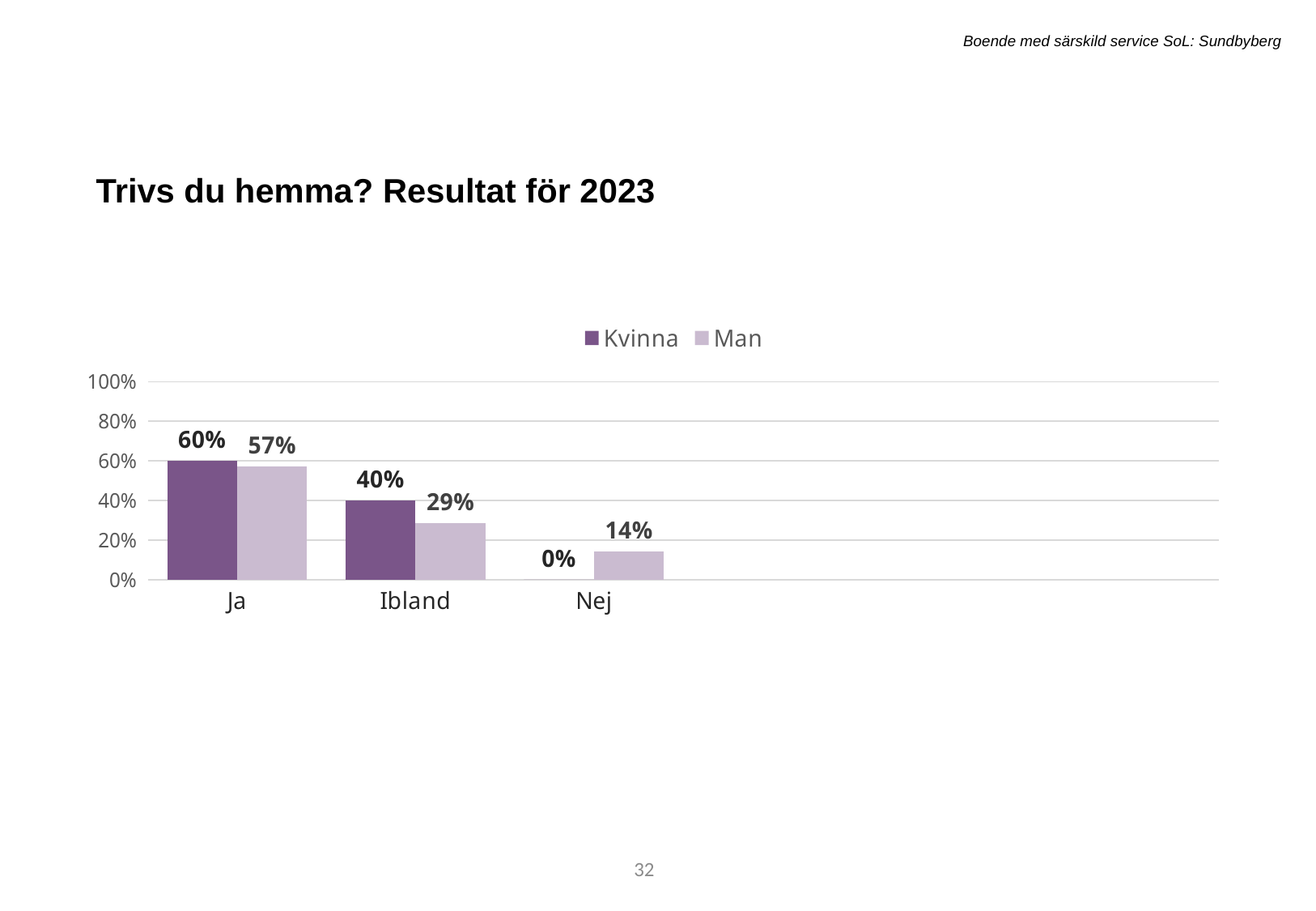
What is the value for Kvinna in the Nej category? 0% In the Ja category, which series has the larger value, Kvinna or Man? Kvinna What is the value for Man in the Nej category? 14% Which category has the lowest value for Kvinna? Nej How many series does the legend list? 2 What is the difference between the Kvinna and Man values in the Ibland category? 11% What is the value for Kvinna in the Ja category? 60% How many categories are shown on the x axis? 3 Do the Kvinna values rise or fall from Ja to Nej along the x axis? Fall What is the value for Man in the Ibland category? 29% Which category has the highest value for Man? Ja What kind of chart is shown on the slide? Bar chart